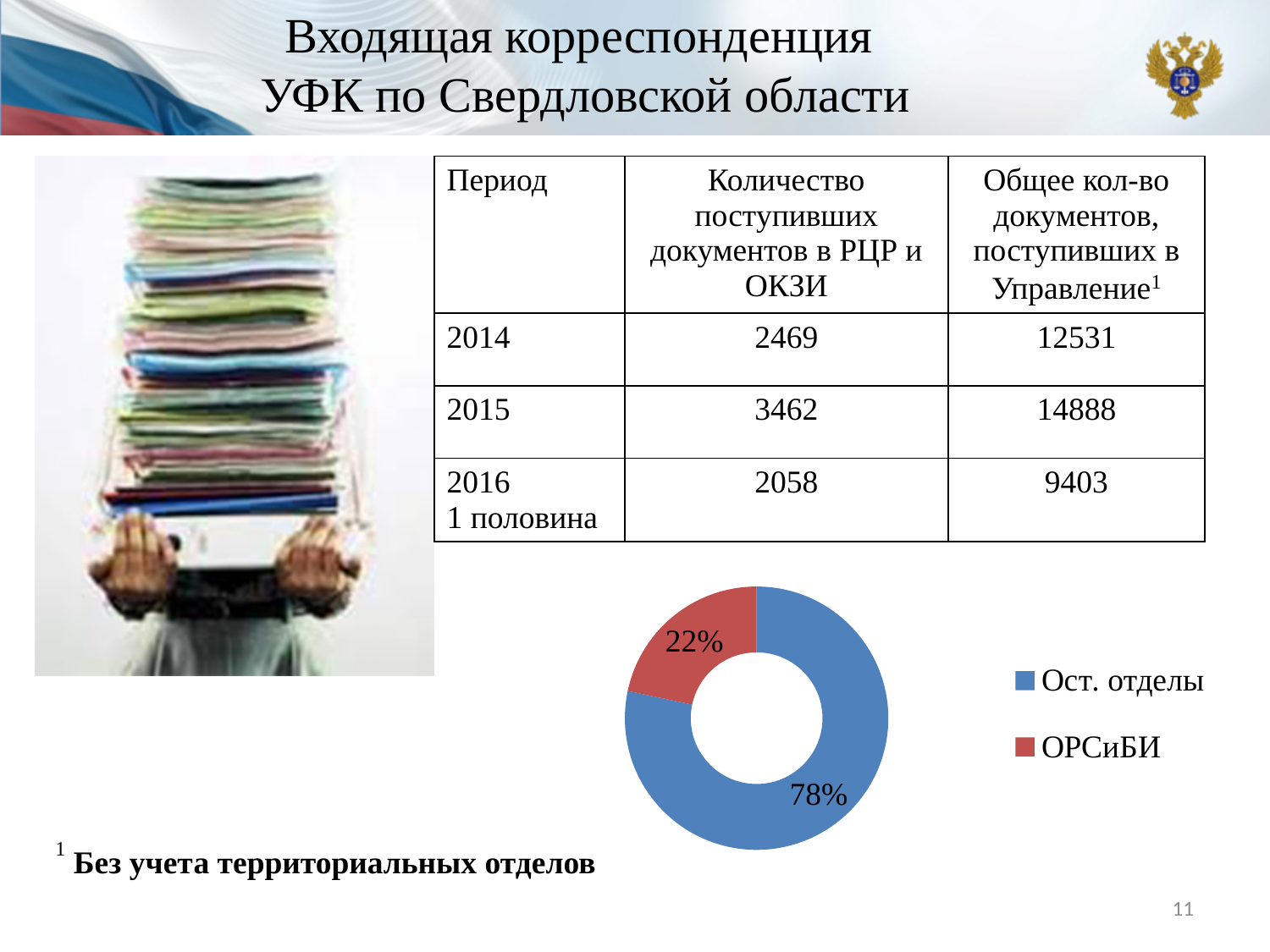
How many slices does the doughnut chart have? 2 Which category has the largest slice in the doughnut chart? Ост. отделы In the doughnut chart, which is larger: the share of Ост. отделы or the share of ОРСиБИ? Ост. отделы In the doughnut chart, what percentage is shown for Ост. отделы? 78% Is the share of Ост. отделы in the doughnut chart greater or less than 50%? greater In the doughnut chart, by how many percentage points does Ост. отделы exceed ОРСиБИ? 56 percentage points How many entries does the legend of the doughnut chart list? 2 What colour represents ОРСиБИ in the doughnut chart? red Which category has the smallest slice in the doughnut chart? ОРСиБИ What is the share of the doughnut chart taken by ОРСиБИ? 22% What kind of chart is shown at the bottom of the slide? doughnut chart In the doughnut chart, what percentage is shown for ОРСиБИ? 22%